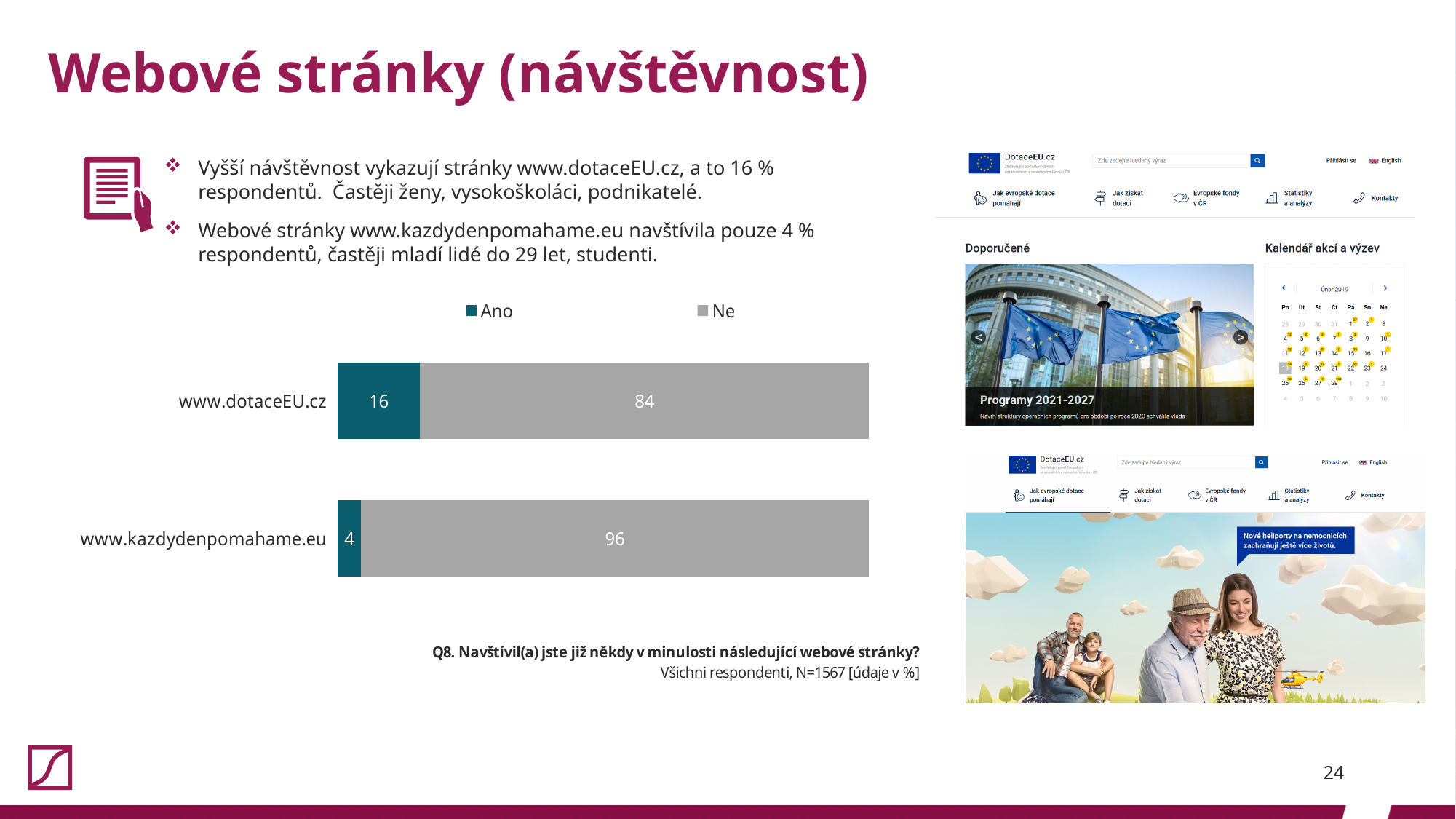
What kind of chart is shown on the slide? stacked bar chart What is the 'Ne' value for www.dotaceEU.cz? 84 What is the 'Ano' value for www.dotaceEU.cz? 16 What is the difference between the 'Ano' values for www.dotaceEU.cz and www.kazdydenpomahame.eu? 12 Which website has the lowest 'Ne' value? www.dotaceEU.cz Is the 'Ne' value for www.dotaceEU.cz larger or smaller than the 'Ne' value for www.kazdydenpomahame.eu? smaller How many websites (categories) are shown in the chart? 2 Which website has the higher 'Ano' value? www.dotaceEU.cz How many series does the legend list? 2 What is the total of the stacked bar for www.kazdydenpomahame.eu? 100 What is the 'Ano' value for www.kazdydenpomahame.eu? 4 What is the 'Ne' value for www.kazdydenpomahame.eu? 96